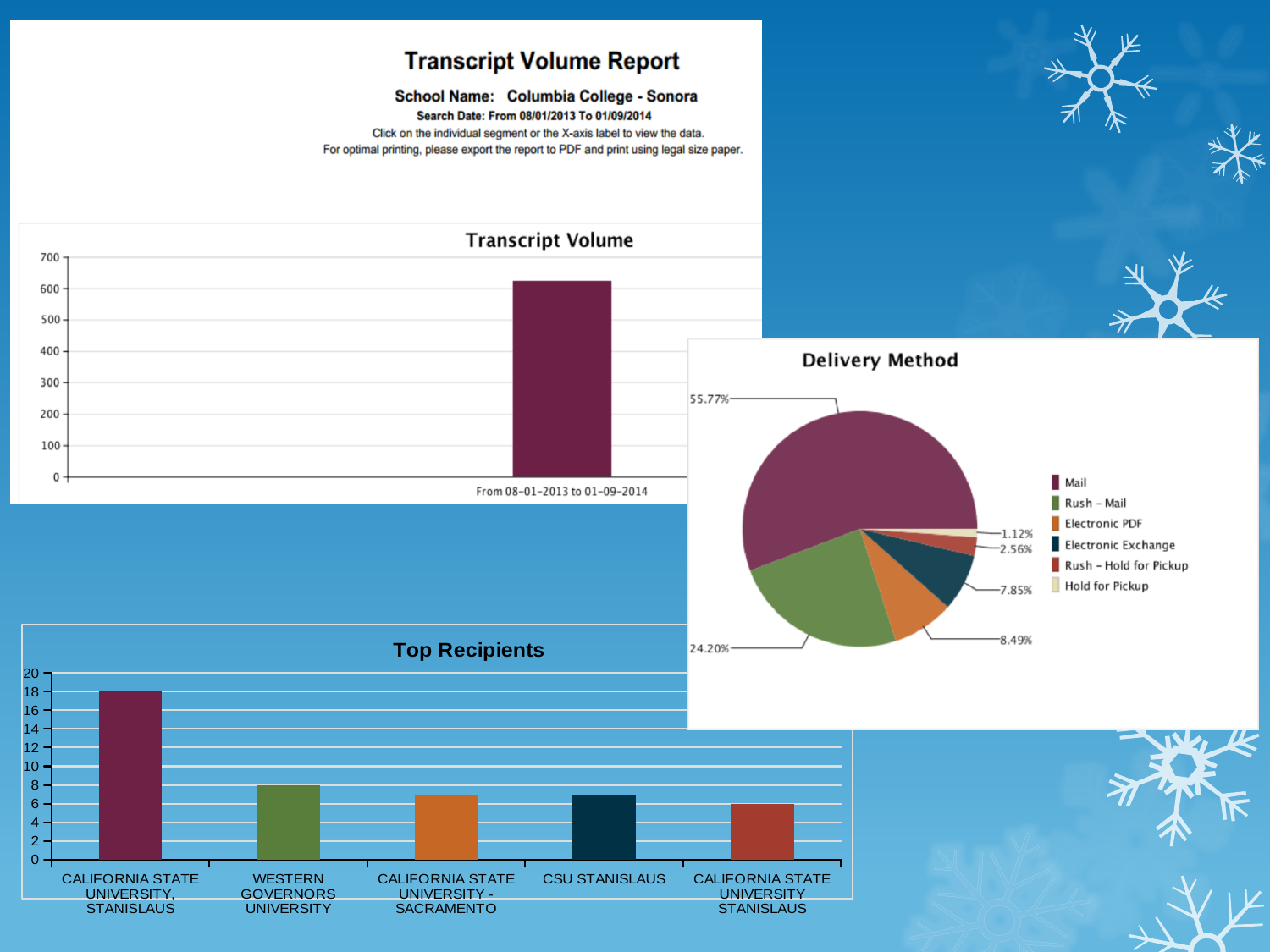
In the Delivery Method chart, what share of the pie is Mail? 55.77% How many bars are shown in the Top Recipients chart? 5 What kind of chart is the Transcript Volume chart? bar chart In the Delivery Method chart, what share of the pie is Rush - Mail? 24.20% In the Top Recipients chart, which is larger: the value for Western Governors University or the value for the last (rightmost) bar? Western Governors University In the Delivery Method chart, what is the difference between the Mail share and the Rush - Mail share? 31.57% In the Top Recipients chart, what is the value of the first (leftmost) bar? 18 In the Top Recipients chart, what is the value for Western Governors University? 8 How many entries does the legend of the Delivery Method chart list? 6 In the Transcript Volume chart, is the value for the bar 'From 08-01-2013 to 01-09-2014' greater or less than 500? greater In the Top Recipients chart, what is the value for California State University - Sacramento? 7 In the Delivery Method chart, which delivery method has the smallest slice? Hold for Pickup